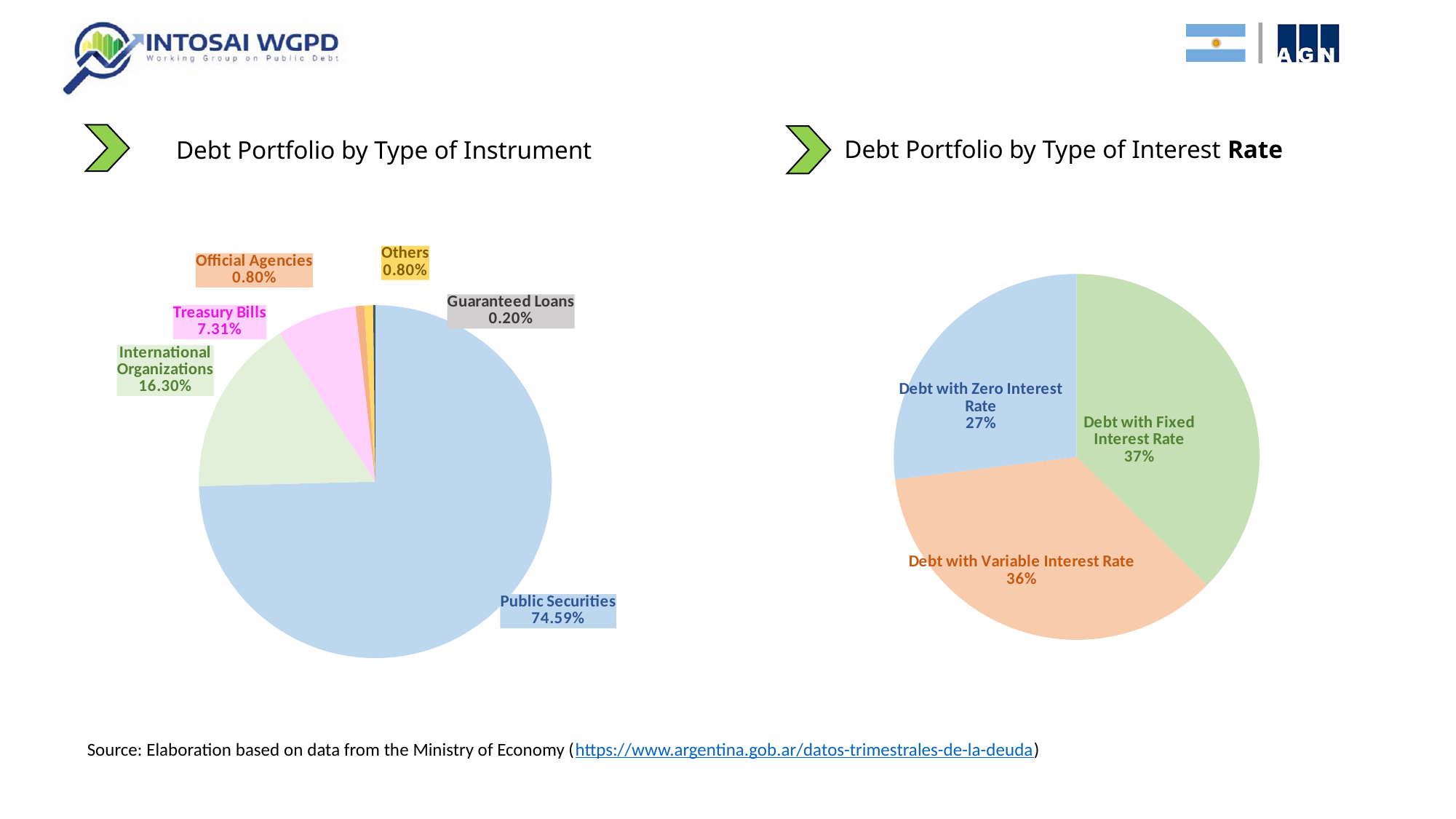
In the 'Debt Portfolio by Type of Interest Rate' chart, what share is Debt with Fixed Interest Rate? 37% In the 'Debt Portfolio by Type of Instrument' chart, how many categories are shown? 6 In the 'Debt Portfolio by Type of Instrument' chart, which category has the smallest share? Guaranteed Loans In the 'Debt Portfolio by Type of Interest Rate' chart, what share is Debt with Zero Interest Rate? 27% In the 'Debt Portfolio by Type of Instrument' chart, what share is International Organizations? 16.30% What kind of chart is the 'Debt Portfolio by Type of Interest Rate' chart? Pie chart In the 'Debt Portfolio by Type of Interest Rate' chart, what is the difference between Debt with Fixed Interest Rate and Debt with Zero Interest Rate? 10% In the 'Debt Portfolio by Type of Instrument' chart, what share is Treasury Bills? 7.31% In the 'Debt Portfolio by Type of Instrument' chart, what share is Public Securities? 74.59% In the 'Debt Portfolio by Type of Interest Rate' chart, which category has the smallest share? Debt with Zero Interest Rate In the 'Debt Portfolio by Type of Instrument' chart, which category has the largest share? Public Securities In the 'Debt Portfolio by Type of Instrument' chart, what is the difference between International Organizations and Treasury Bills? 8.99%